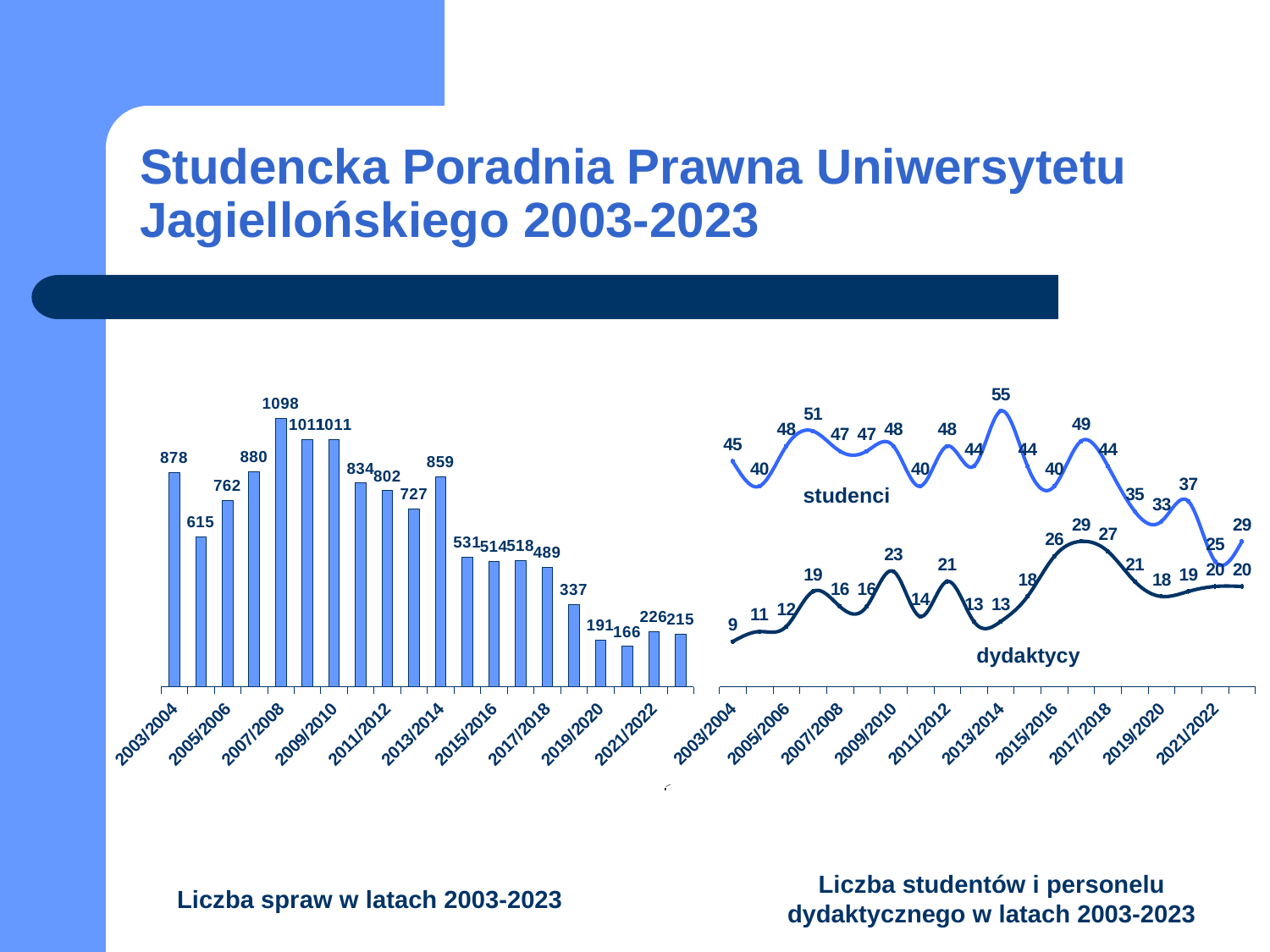
In the left chart 'Liczba spraw w latach 2003-2023', do the values generally rise or fall from 2013/2014 to 2021/2022? fall How many data series are plotted in the right chart 'Liczba studentów i personelu dydaktycznego w latach 2003-2023'? 2 In the left chart 'Liczba spraw w latach 2003-2023', what is the lowest number of cases shown? 166 What kind of chart is the left chart, 'Liczba spraw w latach 2003-2023'? bar chart In the left chart 'Liczba spraw w latach 2003-2023', which academic year has the highest number of cases? 2007/2008 In the right chart 'Liczba studentów i personelu dydaktycznego w latach 2003-2023', which series has the larger value in 2021/2022, studenci or dydaktycy? studenci In the left chart 'Liczba spraw w latach 2003-2023', what is the difference between the number of cases in 2003/2004 and in 2021/2022? 652 In the right chart 'Liczba studentów i personelu dydaktycznego w latach 2003-2023', what is the value for studenci in 2013/2014? 55 How many bars are plotted in the left chart 'Liczba spraw w latach 2003-2023'? 20 In the right chart 'Liczba studentów i personelu dydaktycznego w latach 2003-2023', what is the difference between studenci and dydaktycy in 2013/2014? 42 In the left chart 'Liczba spraw w latach 2003-2023', how many cases are shown for 2007/2008? 1098 In the right chart 'Liczba studentów i personelu dydaktycznego w latach 2003-2023', what is the value for dydaktycy in 2003/2004? 9